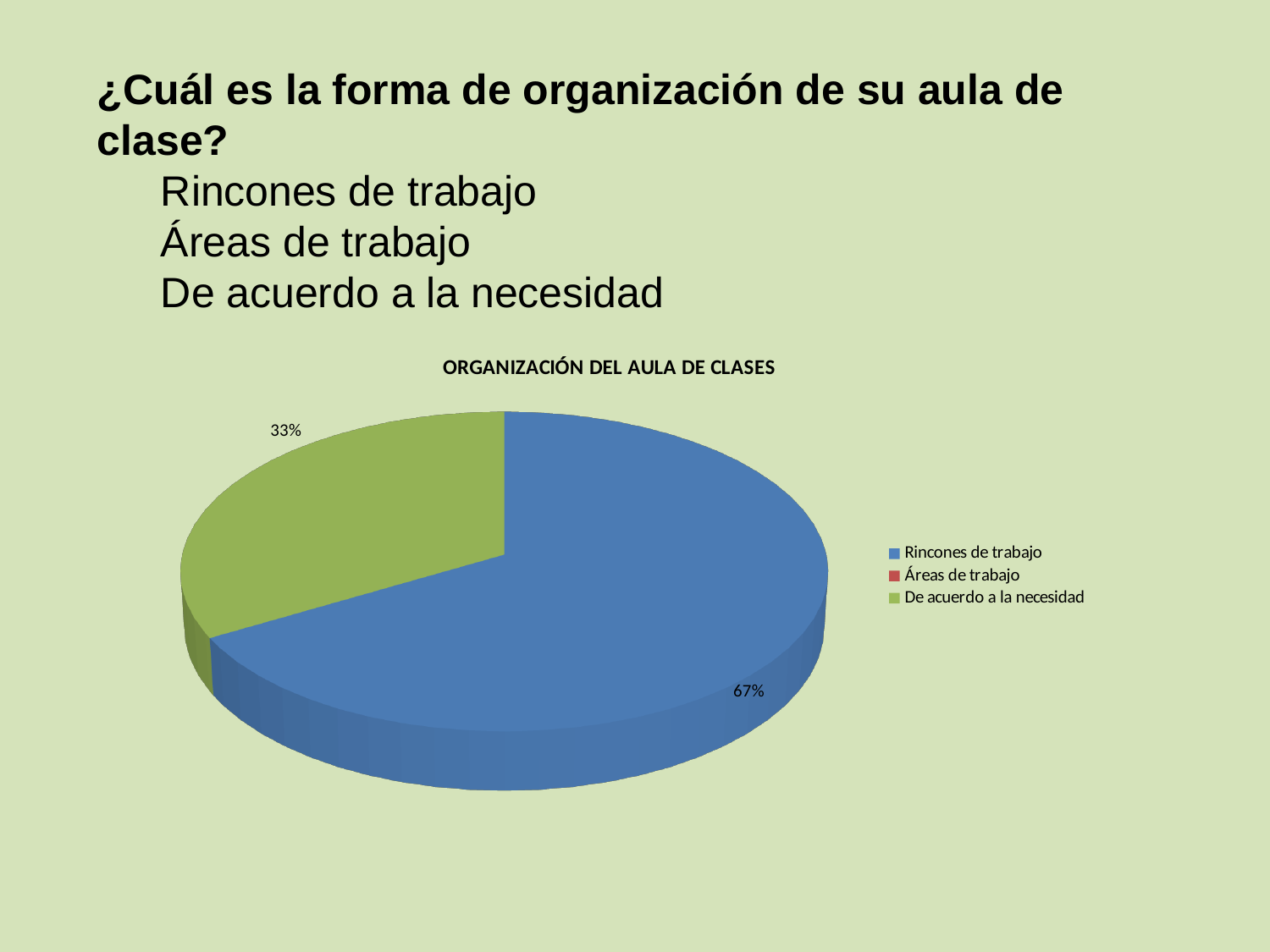
What kind of chart is shown on the slide? Pie chart What share of the pie does Rincones de trabajo represent? 67% What is the difference in percentage points between the Rincones de trabajo slice and the De acuerdo a la necesidad slice? 34 Which category has the largest slice of the pie? Rincones de trabajo What share of the pie does De acuerdo a la necesidad represent? 33% What colour is the slice for Rincones de trabajo? Blue Which of the two labelled slices is larger, Rincones de trabajo or De acuerdo a la necesidad? Rincones de trabajo How many slices are visible in the pie? 2 How many entries does the chart legend list? 3 What is the title of the chart? ORGANIZACIÓN DEL AULA DE CLASES